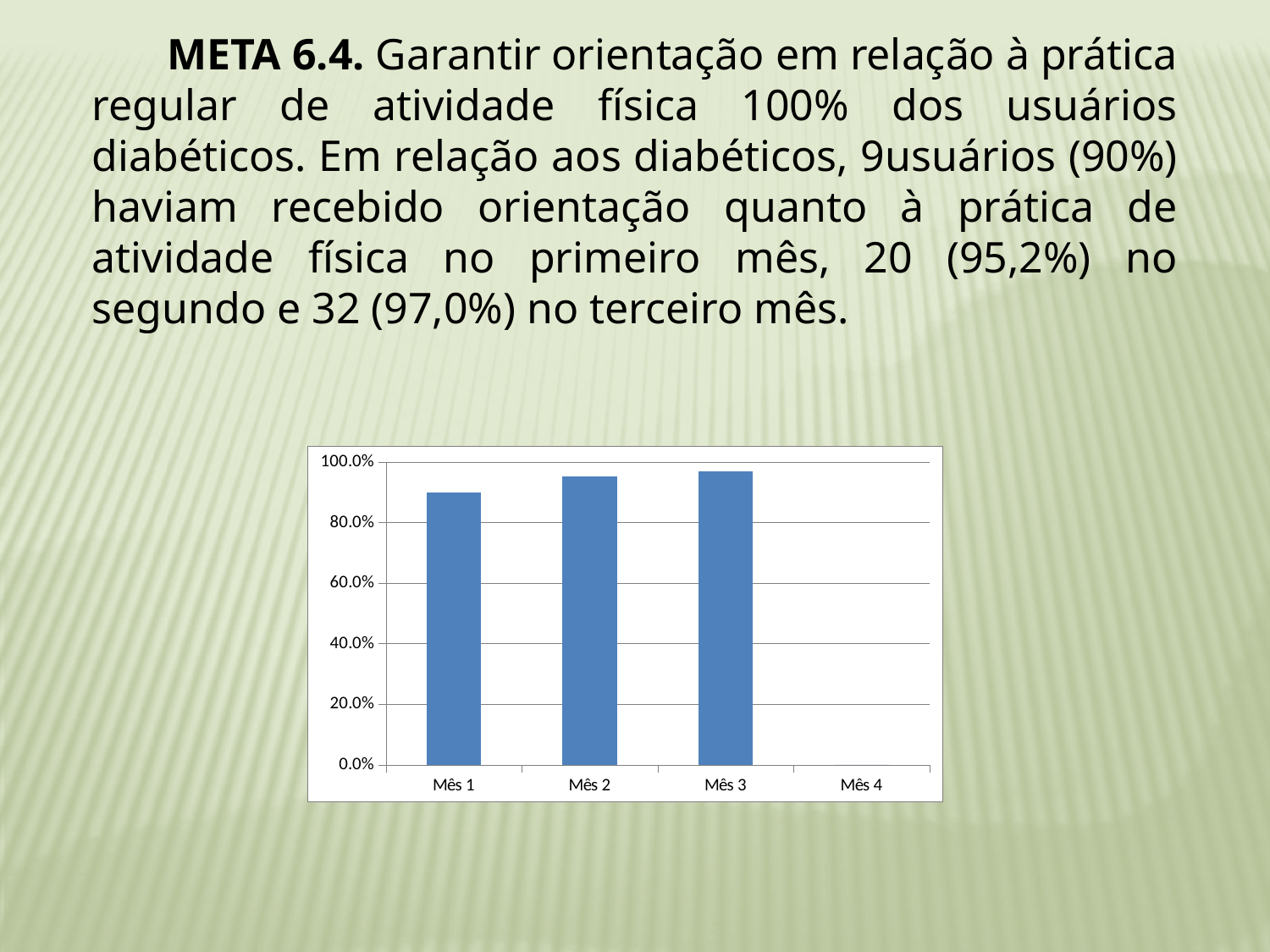
Among Mês 1, Mês 2 and Mês 3, which has the lowest value? Mês 1 How many categories are shown on the x axis of the chart? 4 Do the values rise or fall from Mês 1 to Mês 3? rise Is the value for Mês 2 greater or less than 80.0%? greater Is the value for Mês 3 greater or less than 80.0%? greater What kind of chart is shown on the slide? bar chart Which is larger, the value for Mês 1 or the value for Mês 2? Mês 2 Is the value for Mês 1 greater or less than 100.0%? less Which is larger, the value for Mês 1 or the value for Mês 3? Mês 3 What colour are the bars in the chart? blue